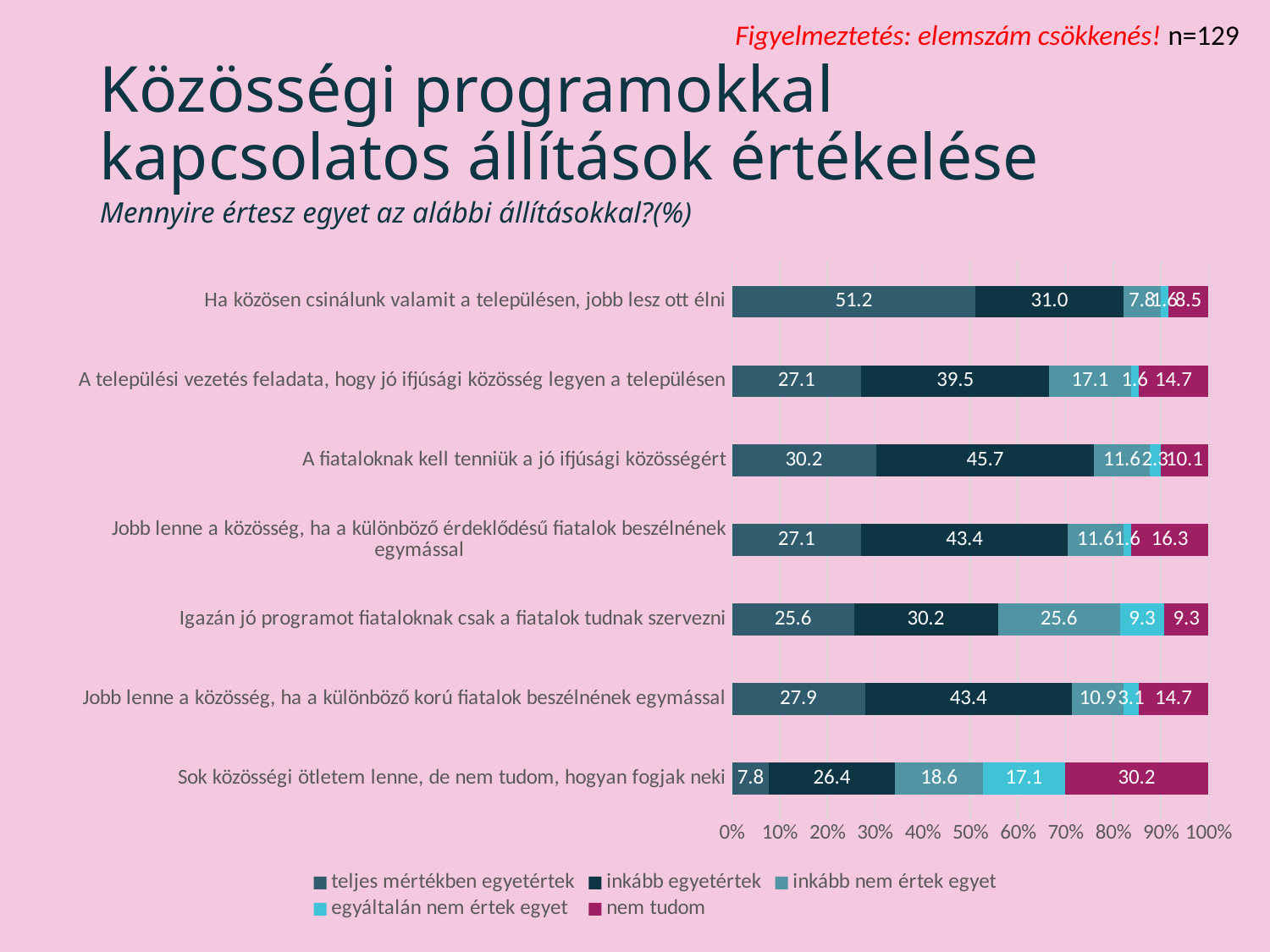
What is the value of 'egyáltalán nem értek egyet' for the statement 'Igazán jó programot fiataloknak csak a fiatalok tudnak szervezni'? 9.3 How many series does the legend list? 5 Which statement has the lowest value for 'teljes mértékben egyetértek'? Sok közösségi ötletem lenne, de nem tudom, hogyan fogjak neki What is the value of 'teljes mértékben egyetértek' for the statement 'Ha közösen csinálunk valamit a településen, jobb lesz ott élni'? 51.2 What is the difference between the 'inkább nem értek egyet' values for 'Igazán jó programot fiataloknak csak a fiatalok tudnak szervezni' and 'Sok közösségi ötletem lenne, de nem tudom, hogyan fogjak neki'? 7.0 What sample size (n) is shown on the slide? n=129 Which statement has the highest value for 'teljes mértékben egyetértek'? Ha közösen csinálunk valamit a településen, jobb lesz ott élni What is the value of 'inkább egyetértek' for the statement 'A fiataloknak kell tenniük a jó ifjúsági közösségért'? 45.7 Which statement has a larger 'nem tudom' value: 'Jobb lenne a közösség, ha a különböző érdeklődésű fiatalok beszélnének egymással' or 'A települési vezetés feladata, hogy jó ifjúsági közösség legyen a településen'? Jobb lenne a közösség, ha a különböző érdeklődésű fiatalok beszélnének egymással What kind of chart is shown on the slide? bar chart What is the value of 'nem tudom' for the statement 'Sok közösségi ötletem lenne, de nem tudom, hogyan fogjak neki'? 30.2 How many statements (categories) are plotted in the chart? 7